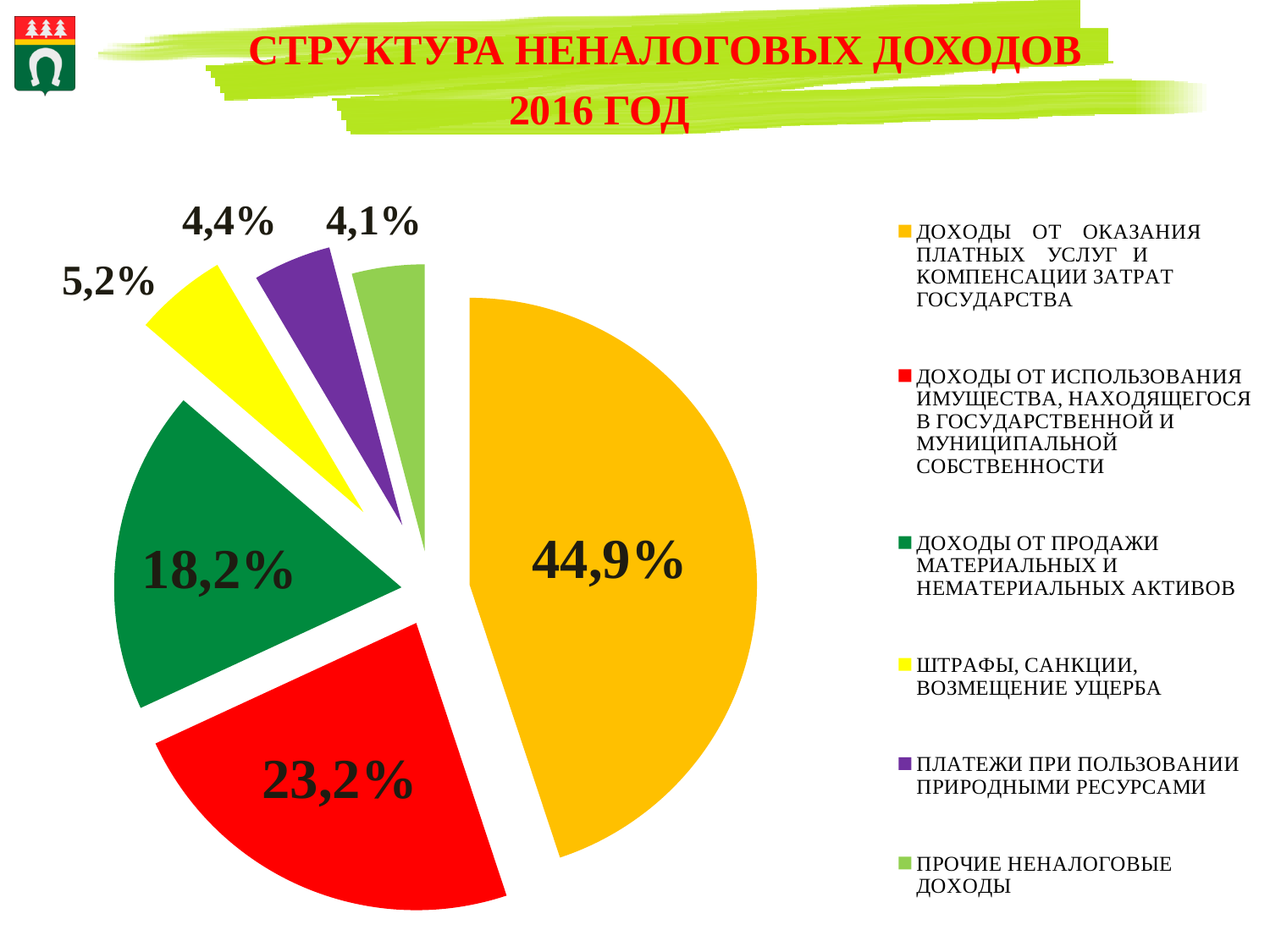
What share is shown for "ПРОЧИЕ НЕНАЛОГОВЫЕ ДОХОДЫ"? 4,1% Which category has the largest share of non-tax revenues? ДОХОДЫ ОТ ОКАЗАНИЯ ПЛАТНЫХ УСЛУГ И КОМПЕНСАЦИИ ЗАТРАТ ГОСУДАРСТВА Which category has the smallest share of non-tax revenues? ПРОЧИЕ НЕНАЛОГОВЫЕ ДОХОДЫ What type of chart is shown on the slide? pie chart What share is shown for "ДОХОДЫ ОТ ПРОДАЖИ МАТЕРИАЛЬНЫХ И НЕМАТЕРИАЛЬНЫХ АКТИВОВ"? 18,2% What is the difference in percentage points between the share for "ДОХОДЫ ОТ ИСПОЛЬЗОВАНИЯ ИМУЩЕСТВА..." and the share for "ДОХОДЫ ОТ ПРОДАЖИ МАТЕРИАЛЬНЫХ И НЕМАТЕРИАЛЬНЫХ АКТИВОВ"? 5,0% What colour is the slice for "ПЛАТЕЖИ ПРИ ПОЛЬЗОВАНИИ ПРИРОДНЫМИ РЕСУРСАМИ"? purple How many categories does the pie chart show? 6 What share is shown for "ШТРАФЫ, САНКЦИИ, ВОЗМЕЩЕНИЕ УЩЕРБА"? 5,2% What share is shown for "ДОХОДЫ ОТ ИСПОЛЬЗОВАНИЯ ИМУЩЕСТВА, НАХОДЯЩЕГОСЯ В ГОСУДАРСТВЕННОЙ И МУНИЦИПАЛЬНОЙ СОБСТВЕННОСТИ"? 23,2% Which is larger: the share for "ШТРАФЫ, САНКЦИИ, ВОЗМЕЩЕНИЕ УЩЕРБА" or the share for "ПЛАТЕЖИ ПРИ ПОЛЬЗОВАНИИ ПРИРОДНЫМИ РЕСУРСАМИ"? ШТРАФЫ, САНКЦИИ, ВОЗМЕЩЕНИЕ УЩЕРБА What share of non-tax revenues comes from "ДОХОДЫ ОТ ОКАЗАНИЯ ПЛАТНЫХ УСЛУГ И КОМПЕНСАЦИИ ЗАТРАТ ГОСУДАРСТВА"? 44,9%